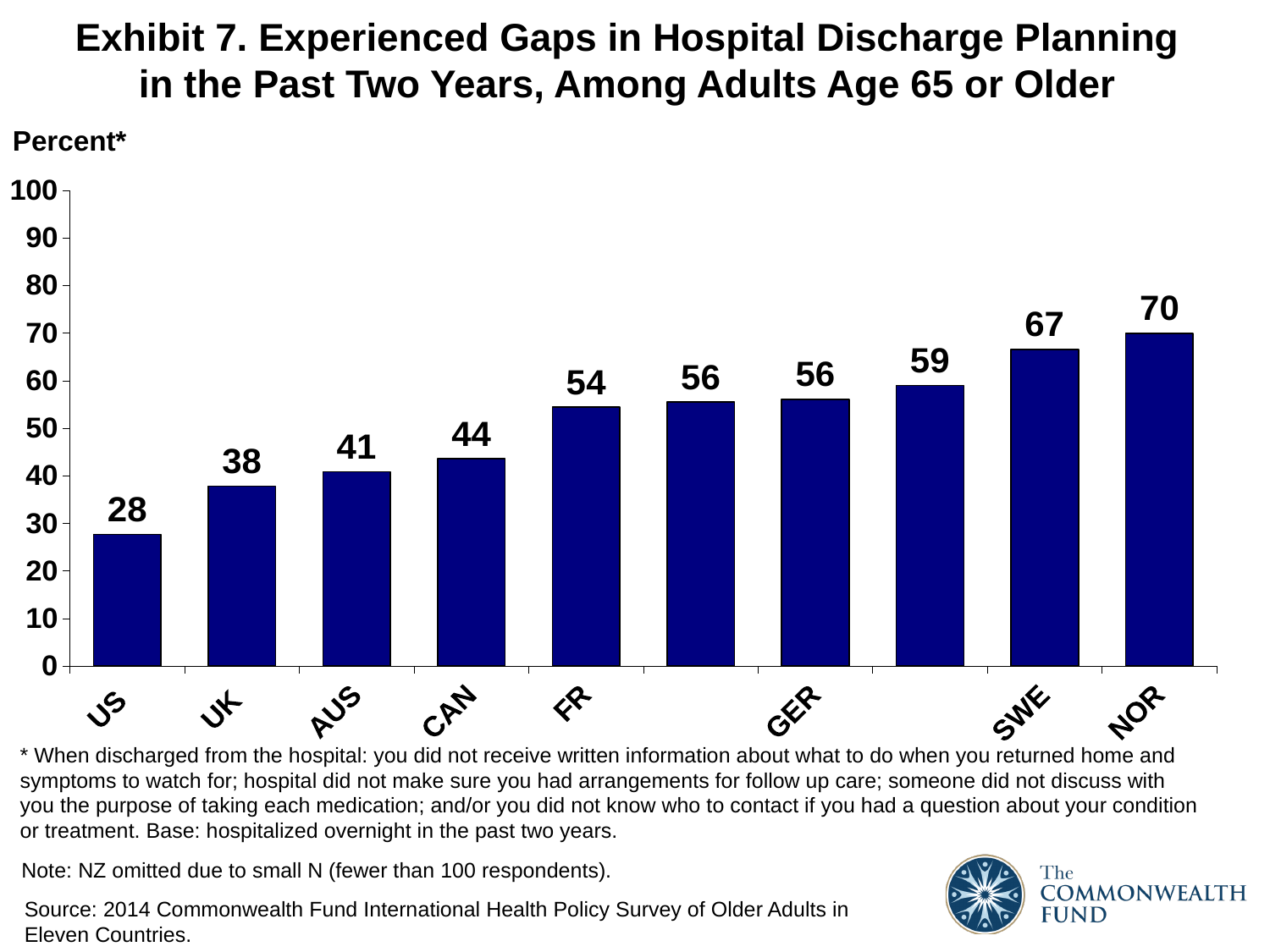
Which country has the highest value? NOR Which is larger, the value for UK or the value for CAN? CAN What is the difference between the values for GER and UK? 18 Which country has the lowest value? US What kind of chart is shown on the slide? bar chart How many bars are shown in the chart? 10 What is the value for SWE? 67 Do the values generally rise or fall from left to right along the x axis? rise What is the value for CAN? 44 What is the value for the US? 28 Is the value for FR greater or less than 50? greater What is the difference between the values for NOR and the US? 42